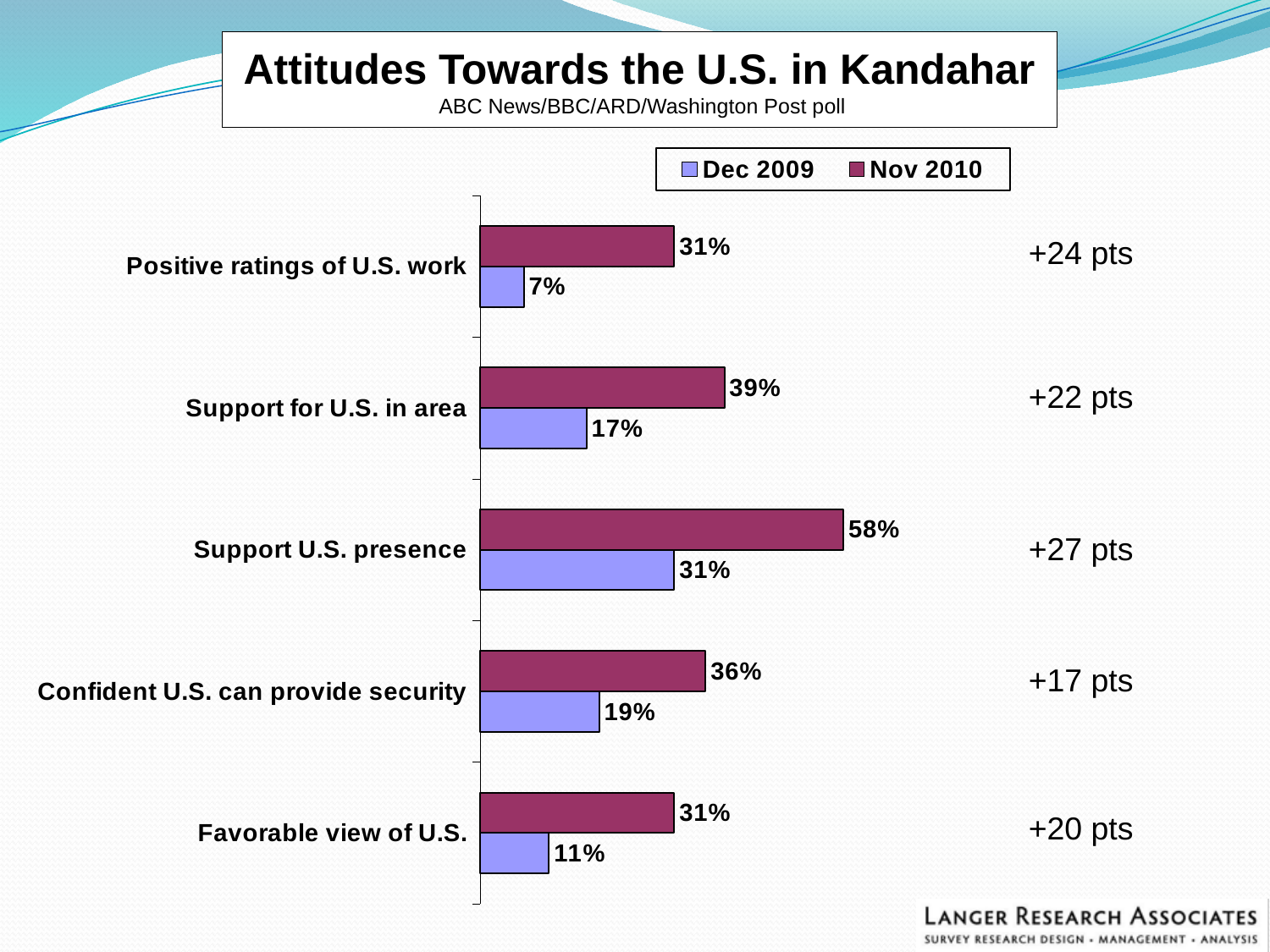
What is the Nov 2010 value for Favorable view of U.S.? 31% Which is larger: the Dec 2009 value for Support U.S. presence or the Dec 2009 value for Favorable view of U.S.? Support U.S. presence What kind of chart is shown on the slide? Bar chart How many series does the legend list? 2 What is the Nov 2010 value for Support U.S. presence? 58% What is the title of the chart? Attitudes Towards the U.S. in Kandahar How many categories are shown in the chart? 5 What is the Dec 2009 value for Confident U.S. can provide security? 19% Which category has the highest Nov 2010 value? Support U.S. presence Which category has the lowest Dec 2009 value? Positive ratings of U.S. work What is the Dec 2009 value for Positive ratings of U.S. work? 7% What is the difference between the Nov 2010 and Dec 2009 values for Support for U.S. in area? 22%